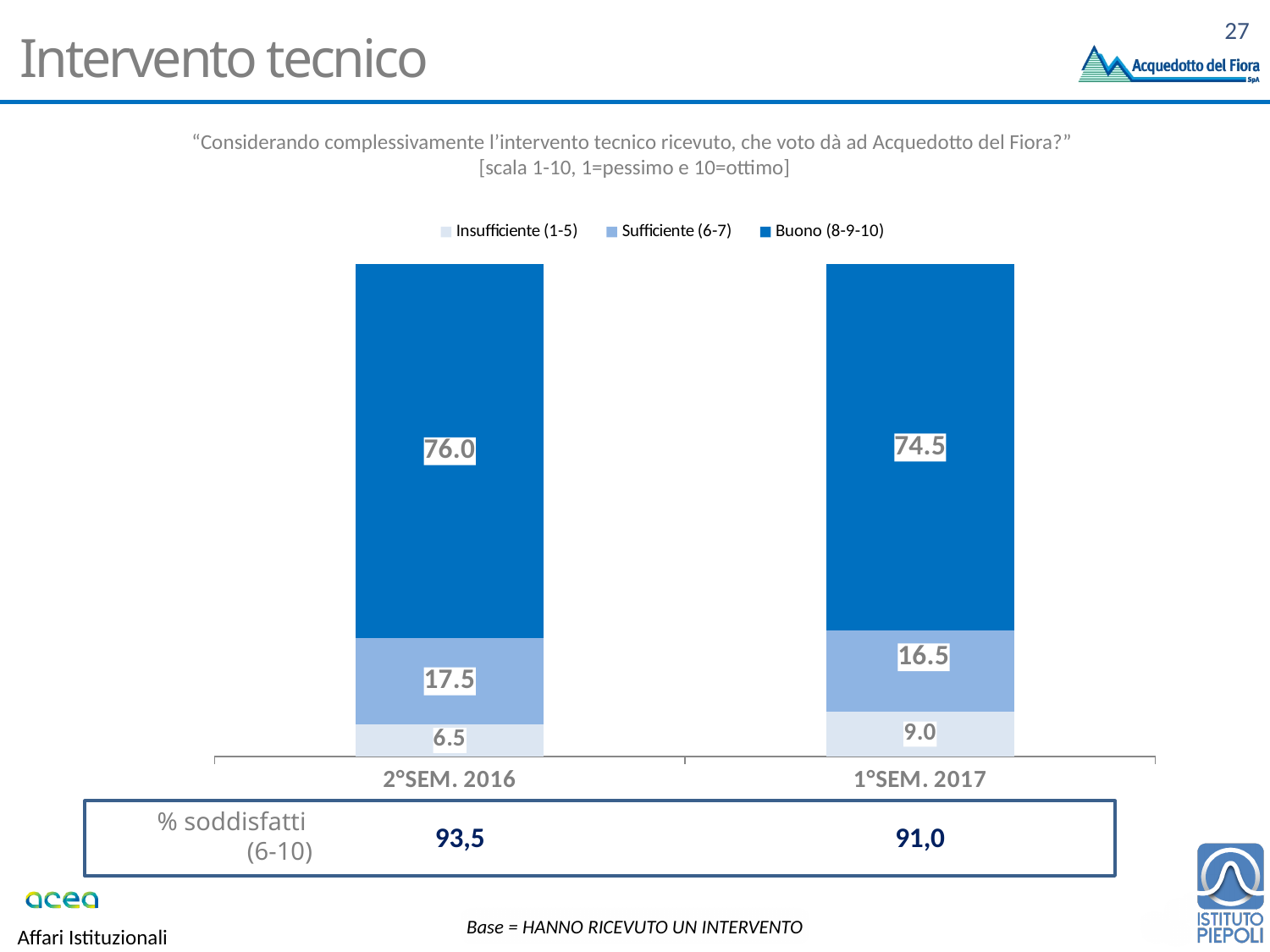
What is the value of Buono (8-9-10) for 1°SEM. 2017? 74.5 What is the value of Buono (8-9-10) for 2°SEM. 2016? 76.0 What kind of chart is shown on the slide? Stacked bar chart What is the value of Insufficiente (1-5) for 1°SEM. 2017? 9.0 Which legend entry is shown in the darkest blue colour? Buono (8-9-10) Which period has the higher value for Insufficiente (1-5)? 1°SEM. 2017 What is the value of Sufficiente (6-7) for 2°SEM. 2016? 17.5 What is the difference between the Sufficiente (6-7) values for 2°SEM. 2016 and 1°SEM. 2017? 1.0 What is the difference between the Buono (8-9-10) values for 2°SEM. 2016 and 1°SEM. 2017? 1.5 How many categories are shown on the x axis? 2 How many series does the legend list? 3 What is the total of the stacked bar for 2°SEM. 2016? 100.0